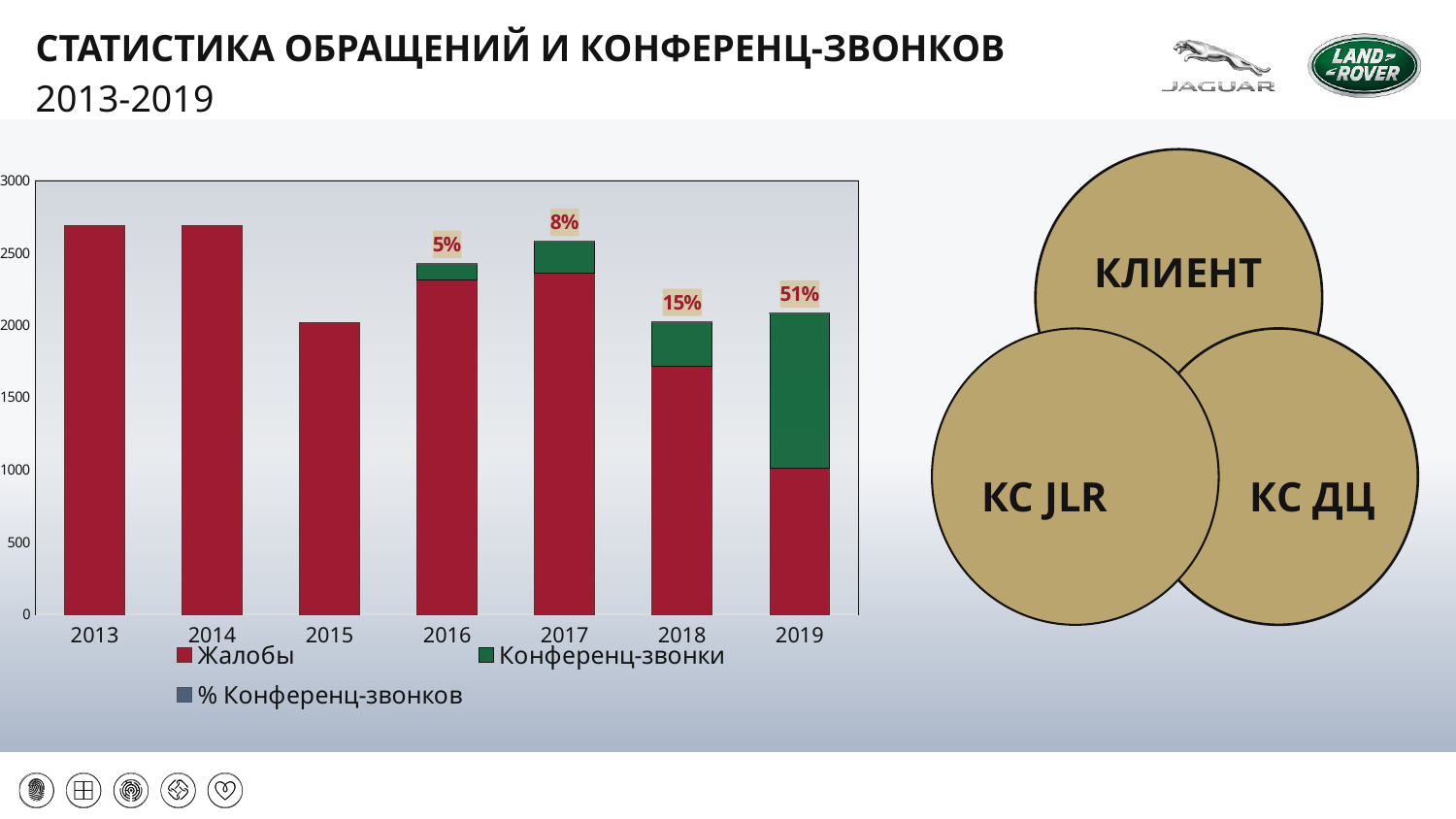
Which year has the highest % Конференц-звонков label? 2019 What percentage label is shown above the 2019 bar? 51% What percentage label is shown above the 2016 bar? 5% Is the Жалобы value for 2013 greater or less than 2500? greater Is the Жалобы value for 2018 greater or less than 1500? greater Which series is shown in red in the chart? Жалобы What kind of chart is shown on the slide? Stacked bar chart What percentage label is shown above the 2018 bar? 15% Which year has the larger Жалобы value, 2013 or 2015? 2013 How many series does the chart legend list? 3 How many years are shown on the x axis of the chart? 7 What is the difference between the % Конференц-звонков labels for 2019 and 2018? 36%